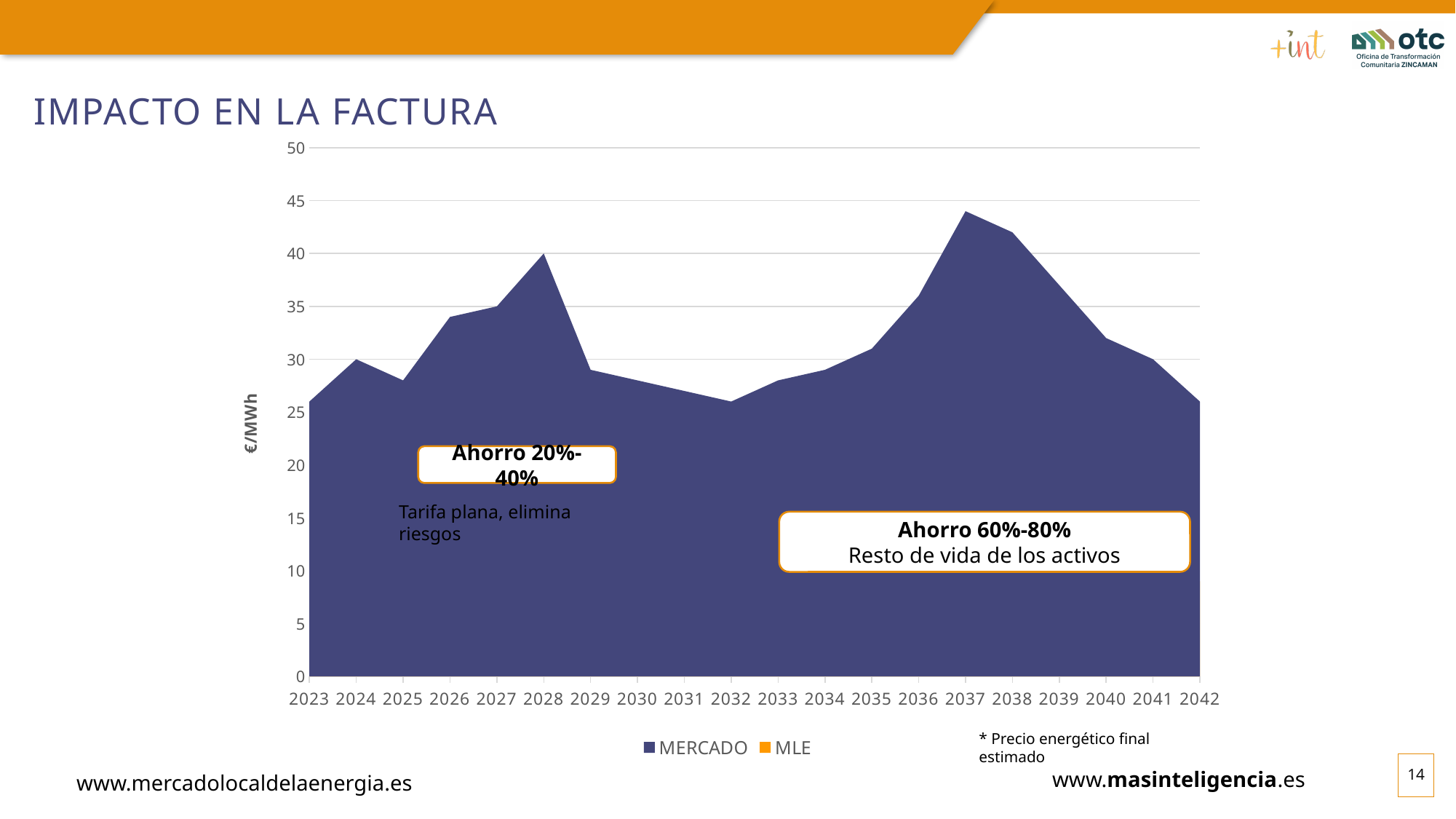
How many years are shown on the x axis? 20 In which year does the MERCADO series reach its highest value? 2037 Is the MERCADO value for 2037 greater or less than 40? greater Does the MERCADO series rise or fall between 2032 and 2037? rise What kind of chart is shown on the slide? Area chart What are the two entries in the chart legend? MERCADO and MLE Which year has a higher MERCADO value, 2026 or 2032? 2026 Which year has a higher MERCADO value, 2028 or 2037? 2037 How many series does the legend list? 2 Is the MERCADO value for 2028 greater or less than 35? greater What is the label on the y axis? €/MWh Is the MERCADO value for 2032 greater or less than 30? less